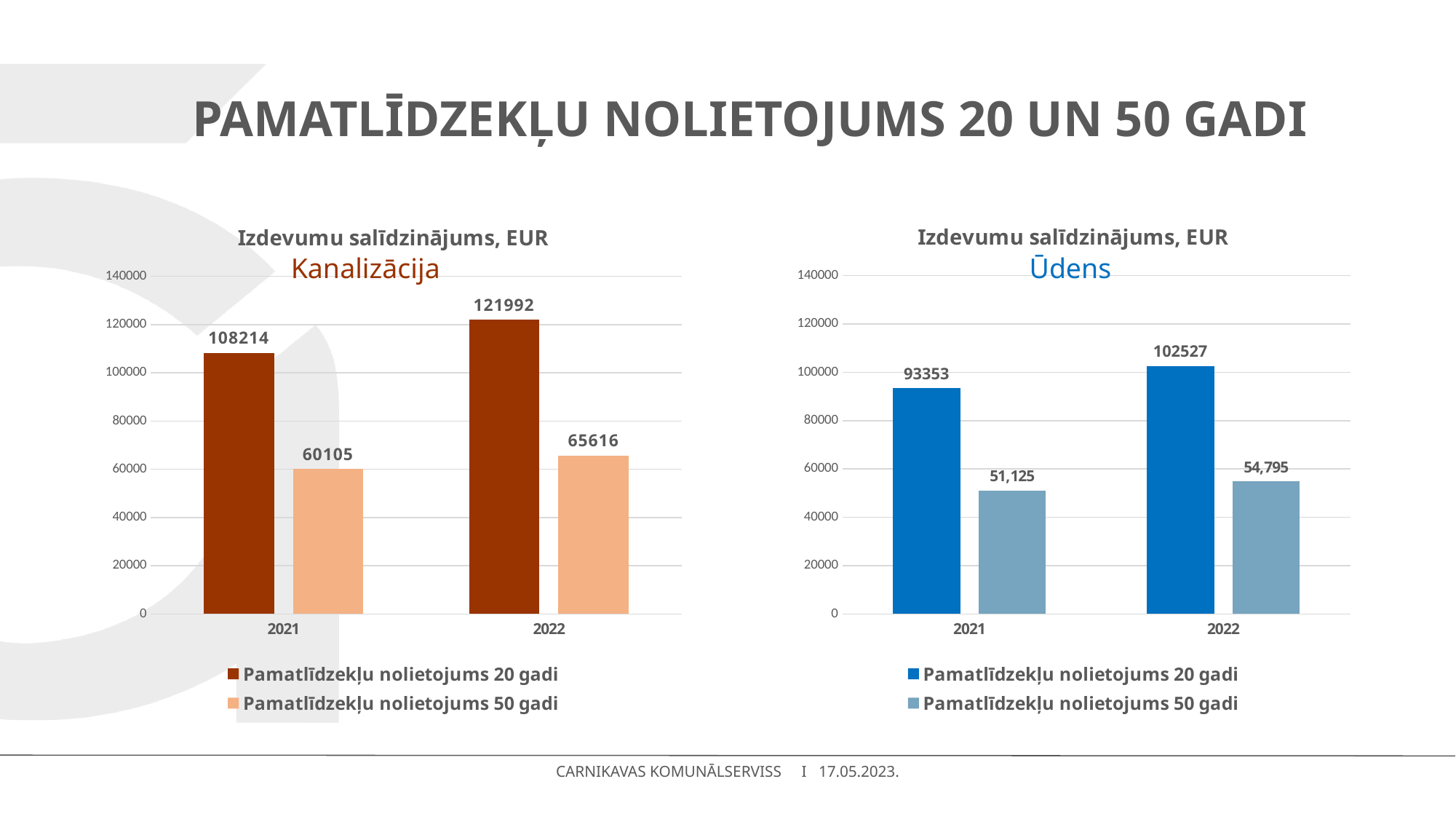
In the Kanalizācija chart, which bar has the highest value? Pamatlīdzekļu nolietojums 20 gadi in 2022 In the Ūdens chart, what is the difference between the 20 gadi values for 2022 and 2021? 9174 In the Ūdens chart, which is larger: the 50 gadi value in 2021 or in 2022? 2022 In the Kanalizācija chart, what is the difference between the 20 gadi and 50 gadi values in 2021? 48109 What type of chart is the Kanalizācija chart? bar chart In the Ūdens chart, what is the value for Pamatlīdzekļu nolietojums 20 gadi in 2021? 93353 In the Kanalizācija chart, what is the value for Pamatlīdzekļu nolietojums 20 gadi in 2022? 121992 How many series does the legend of the Ūdens chart list? 2 In the Kanalizācija chart, does the Pamatlīdzekļu nolietojums 20 gadi value rise or fall from 2021 to 2022? rise In the Ūdens chart, what is the value for Pamatlīdzekļu nolietojums 50 gadi in 2022? 54,795 In the Ūdens chart, which bar has the lowest value? Pamatlīdzekļu nolietojums 50 gadi in 2021 In the Kanalizācija chart, what is the value for Pamatlīdzekļu nolietojums 50 gadi in 2021? 60105